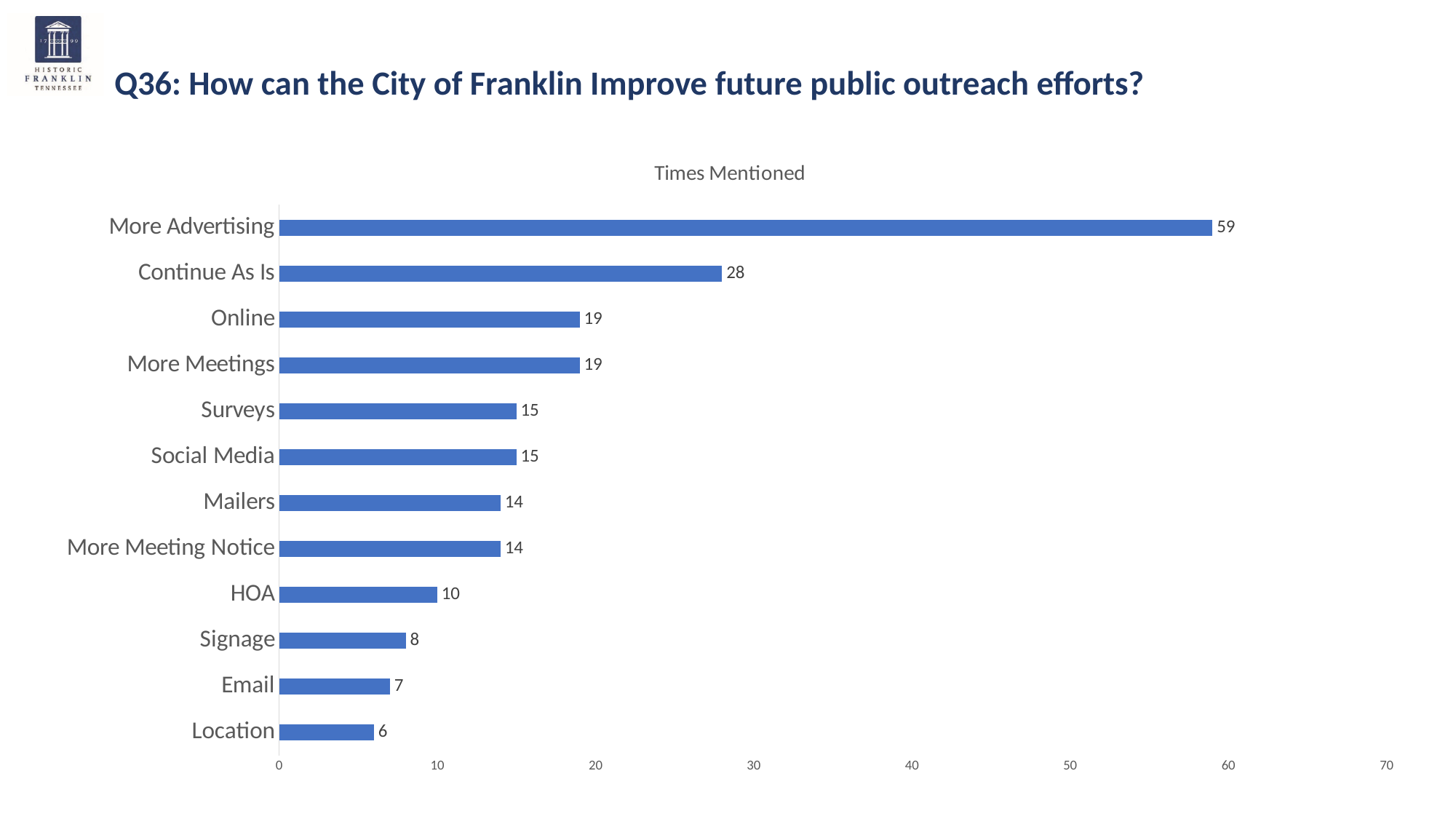
How many categories are shown in the chart? 12 What is the difference between the values for More Advertising and Continue As Is? 31 Is the value for Continue As Is greater or less than 20? greater What is the difference between the values for Signage and Email? 1 Which category has the lowest number of times mentioned? Location What kind of chart is shown on the slide? Bar chart What is the value for Continue As Is? 28 Which is larger, the value for Online or the value for Surveys? Online Which category has the highest number of times mentioned? More Advertising What is the title of the chart? Times Mentioned How many times was HOA mentioned? 10 How many times was More Advertising mentioned? 59